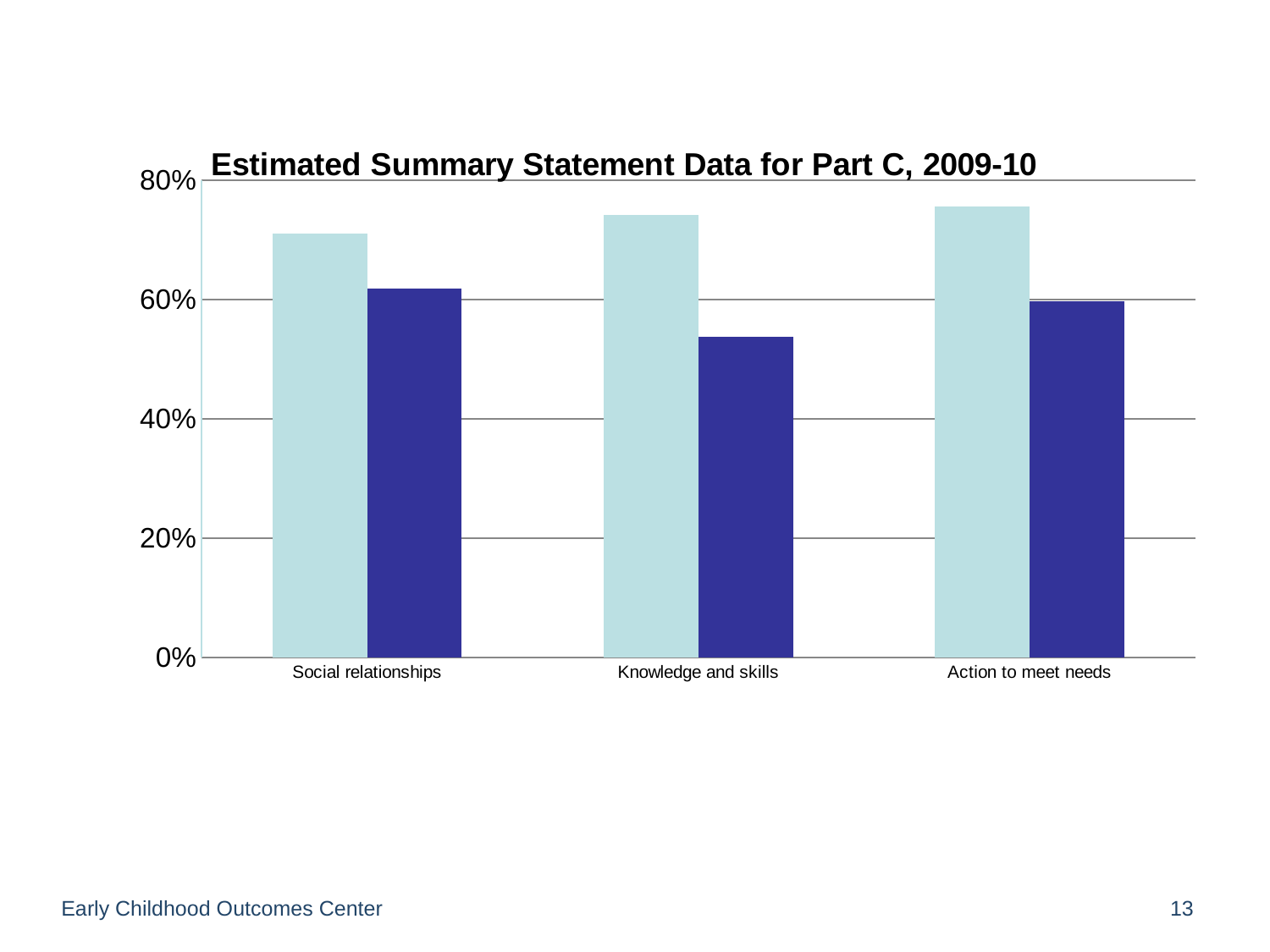
Which category has the lowest light blue bar? Social relationships Is the dark blue bar for Knowledge and skills greater or less than 60%? less Is the light blue bar for Knowledge and skills greater or less than 60%? greater Which category has the lowest dark blue bar? Knowledge and skills Is the dark blue bar for Knowledge and skills greater or less than 40%? greater For Knowledge and skills, which bar is taller, the light blue bar or the dark blue bar? the light blue bar What kind of chart is shown on the slide? bar chart What is the title of the chart? Estimated Summary Statement Data for Part C, 2009-10 How many categories are shown on the x axis of the chart? 3 Which category has the highest light blue bar? Action to meet needs